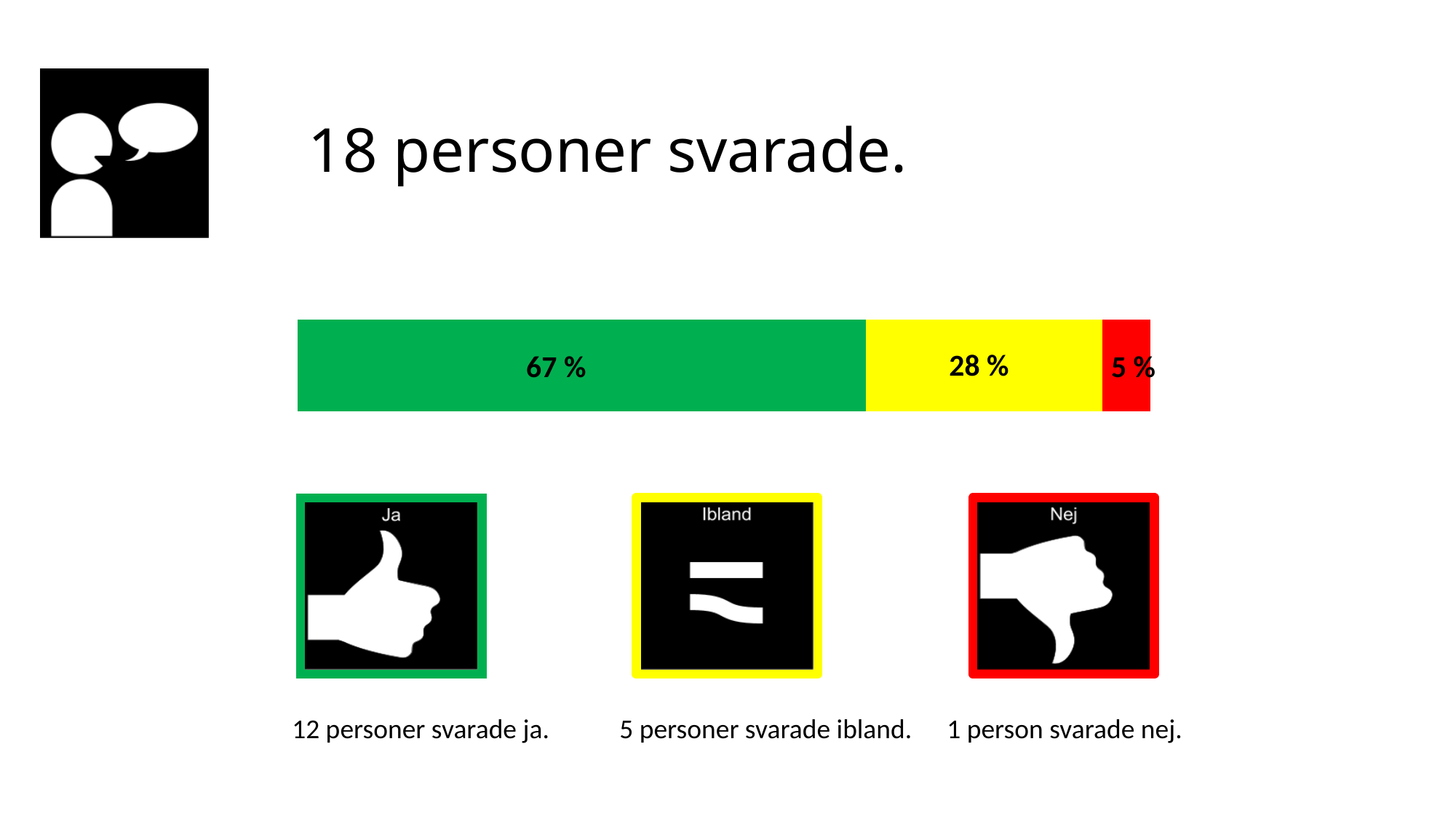
Which segment of the bar has the smallest percentage? 5 % (red, Nej) What percentage does the green segment of the bar show? 67 % Which is larger, the yellow segment or the red segment? The yellow segment What is the difference in percentage points between the green segment and the yellow segment? 39 What percentage does the yellow segment of the bar show? 28 % What kind of chart is shown on the slide? A stacked horizontal bar chart What is the total of the three percentages shown on the bar? 100 % What colour is the segment labelled 28 %? Yellow How many segments does the stacked bar have? 3 What is the difference in percentage points between the yellow segment and the red segment? 23 What percentage does the red segment of the bar show? 5 % Which segment of the bar has the largest percentage? 67 % (green, Ja)